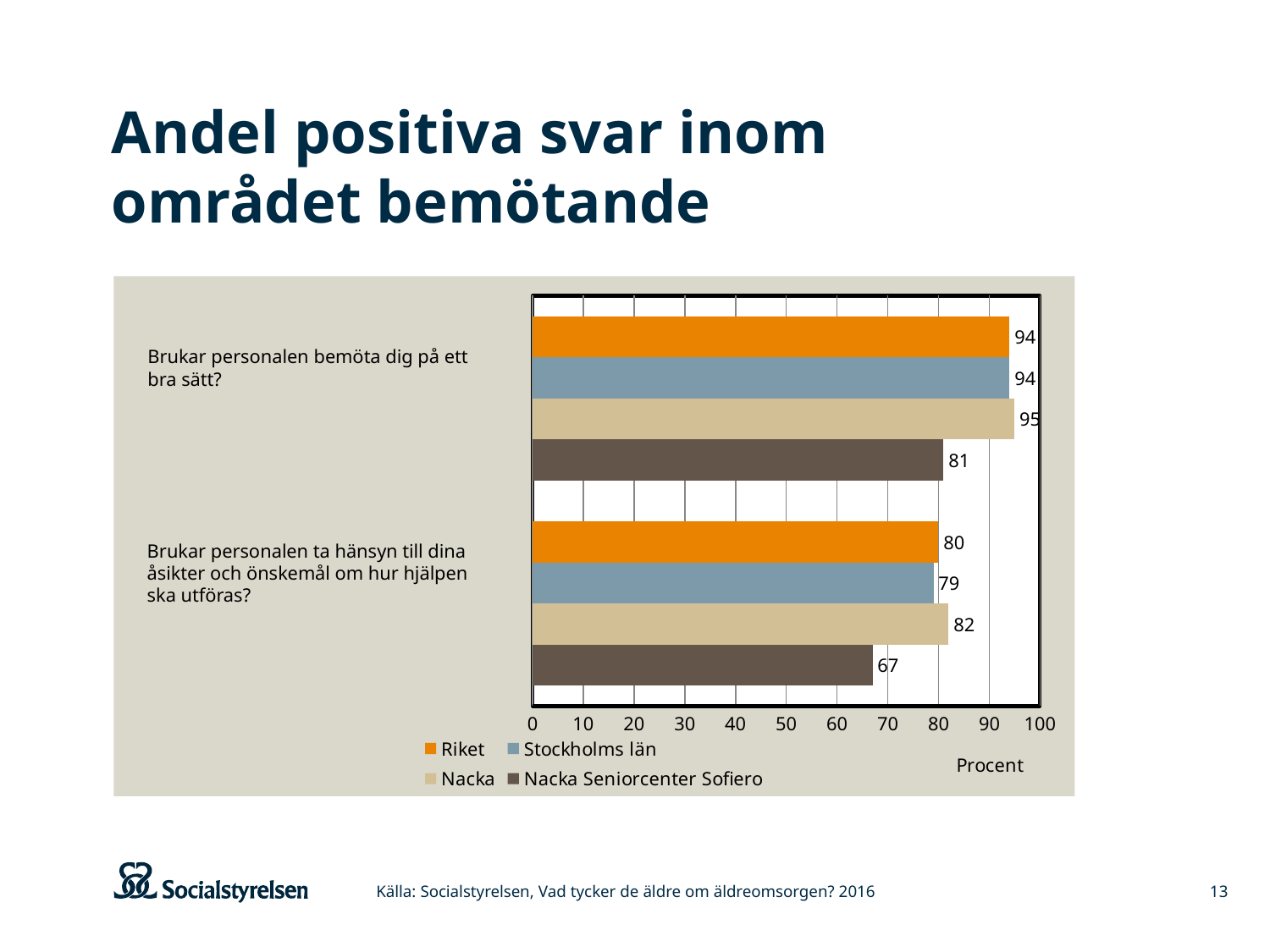
What is the value for Nacka Seniorcenter Sofiero for "Brukar personalen bemöta dig på ett bra sätt?"? 81 What is the value for Riket for "Brukar personalen ta hänsyn till dina åsikter och önskemål om hur hjälpen ska utföras?"? 80 What is the value for Nacka for "Brukar personalen bemöta dig på ett bra sätt?"? 95 How many question categories are plotted on the chart? 2 Which series has the lowest value for "Brukar personalen ta hänsyn till dina åsikter och önskemål om hur hjälpen ska utföras?"? Nacka Seniorcenter Sofiero Is the value for Nacka Seniorcenter Sofiero for "Brukar personalen bemöta dig på ett bra sätt?" larger or smaller than its value for "Brukar personalen ta hänsyn till dina åsikter och önskemål om hur hjälpen ska utföras?"? larger Which series has the highest value for "Brukar personalen bemöta dig på ett bra sätt?"? Nacka What is the value for Stockholms län for "Brukar personalen ta hänsyn till dina åsikter och önskemål om hur hjälpen ska utföras?"? 79 What is the difference between the Nacka value and the Nacka Seniorcenter Sofiero value for "Brukar personalen ta hänsyn till dina åsikter och önskemål om hur hjälpen ska utföras?"? 15 What unit label is shown below the x axis of the chart? Procent How many series does the legend list? 4 What kind of chart is shown on the slide? bar chart